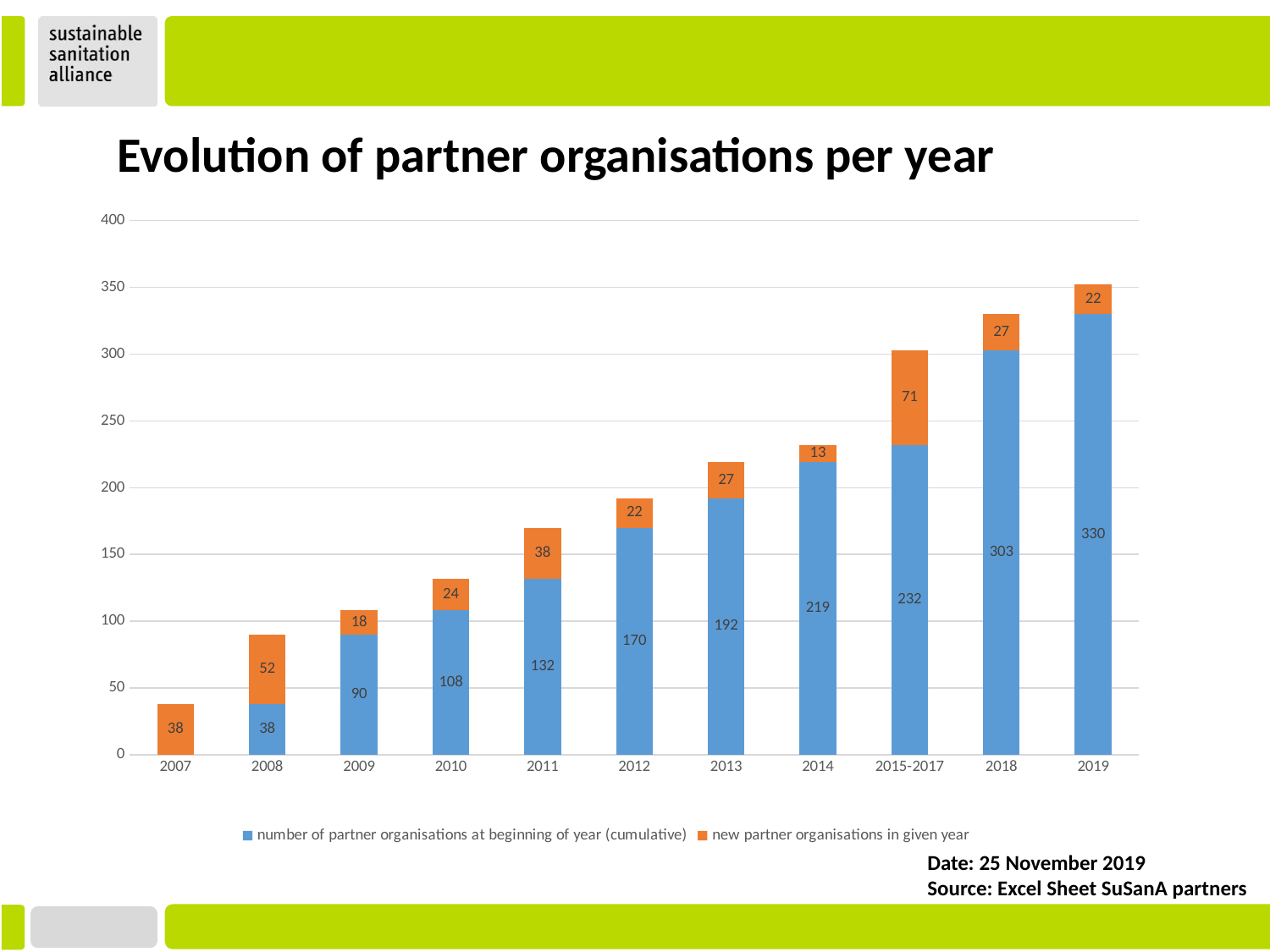
Which period has the highest number of new partner organisations in a given year? 2015-2017 How many series does the legend list? 2 What is the total height of the stacked bar for 2019? 352 What is the difference between the cumulative number of partner organisations at the beginning of 2019 and at the beginning of 2018? 27 What type of chart is shown on the slide? stacked bar chart How many new partner organisations were added in 2015-2017? 71 What colour represents new partner organisations in a given year? orange How many year categories are shown on the x axis? 11 Which is larger: the number of new partner organisations in 2008 or in 2011? 2008 Which year has the lowest number of new partner organisations in a given year? 2014 What is the number of partner organisations at the beginning of 2013 (cumulative)? 192 Does the cumulative number of partner organisations at the beginning of year rise or fall from 2008 to 2019? rise